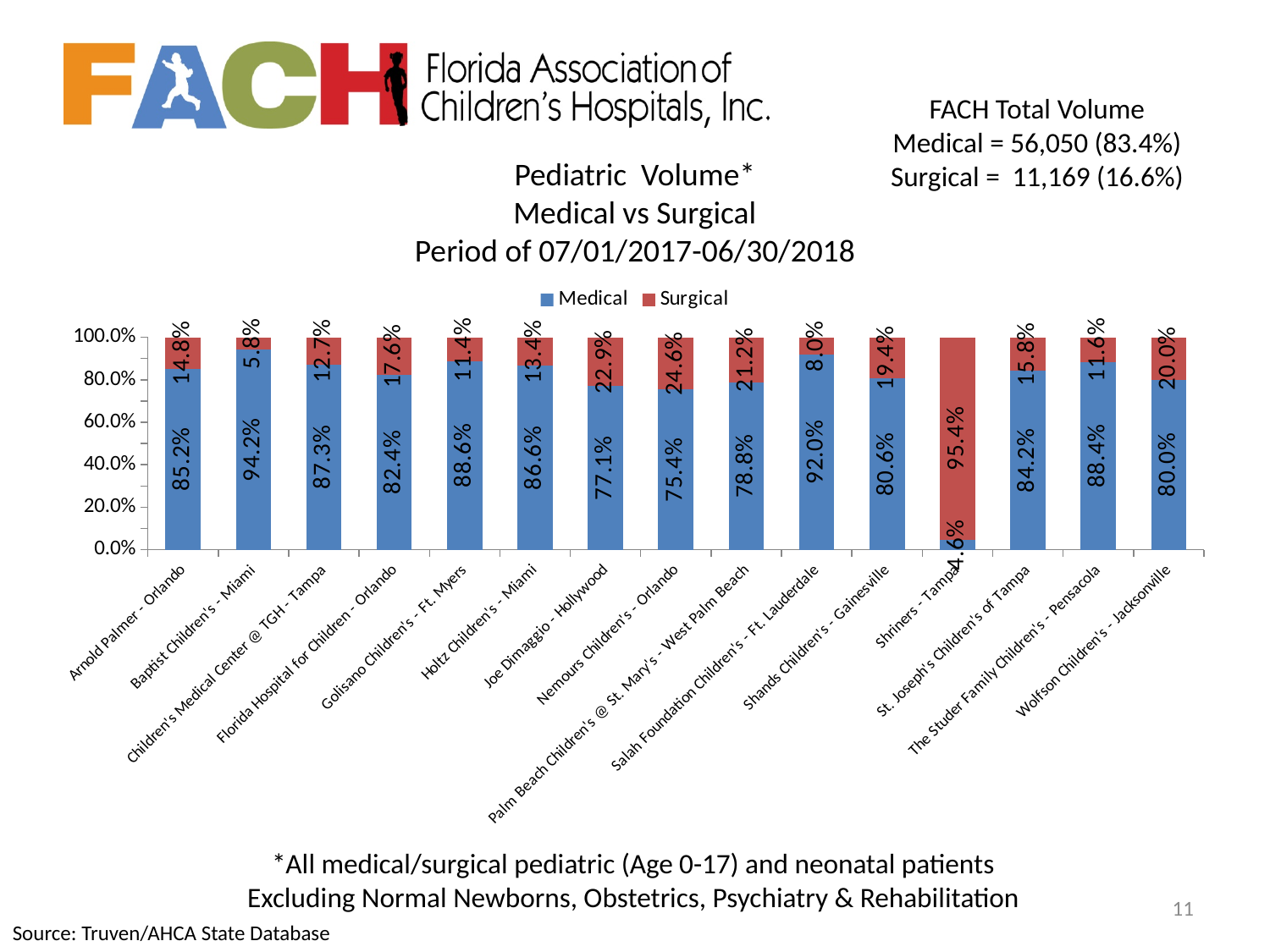
How many hospitals are shown on the x axis of the chart? 15 Which hospital has the lowest Medical percentage? Shriners - Tampa What is the Medical percentage for Wolfson Children's - Jacksonville? 80.0% What is the difference between the Surgical percentages of Joe DiMaggio - Hollywood and Salah Foundation Children's - Ft. Lauderdale? 14.9% Which has a larger Medical percentage, Golisano Children's - Ft. Myers or Holtz Children's - Miami? Golisano Children's - Ft. Myers How many series does the legend list? 2 What is the Surgical percentage for Shriners - Tampa? 95.4% What is the Medical percentage for Baptist Children's - Miami? 94.2% What colour represents the Surgical series in the chart? Red What is the Surgical percentage for Nemours Children's - Orlando? 24.6% Which hospital has the highest Medical percentage? Baptist Children's - Miami What kind of chart is shown on the slide? Stacked bar chart